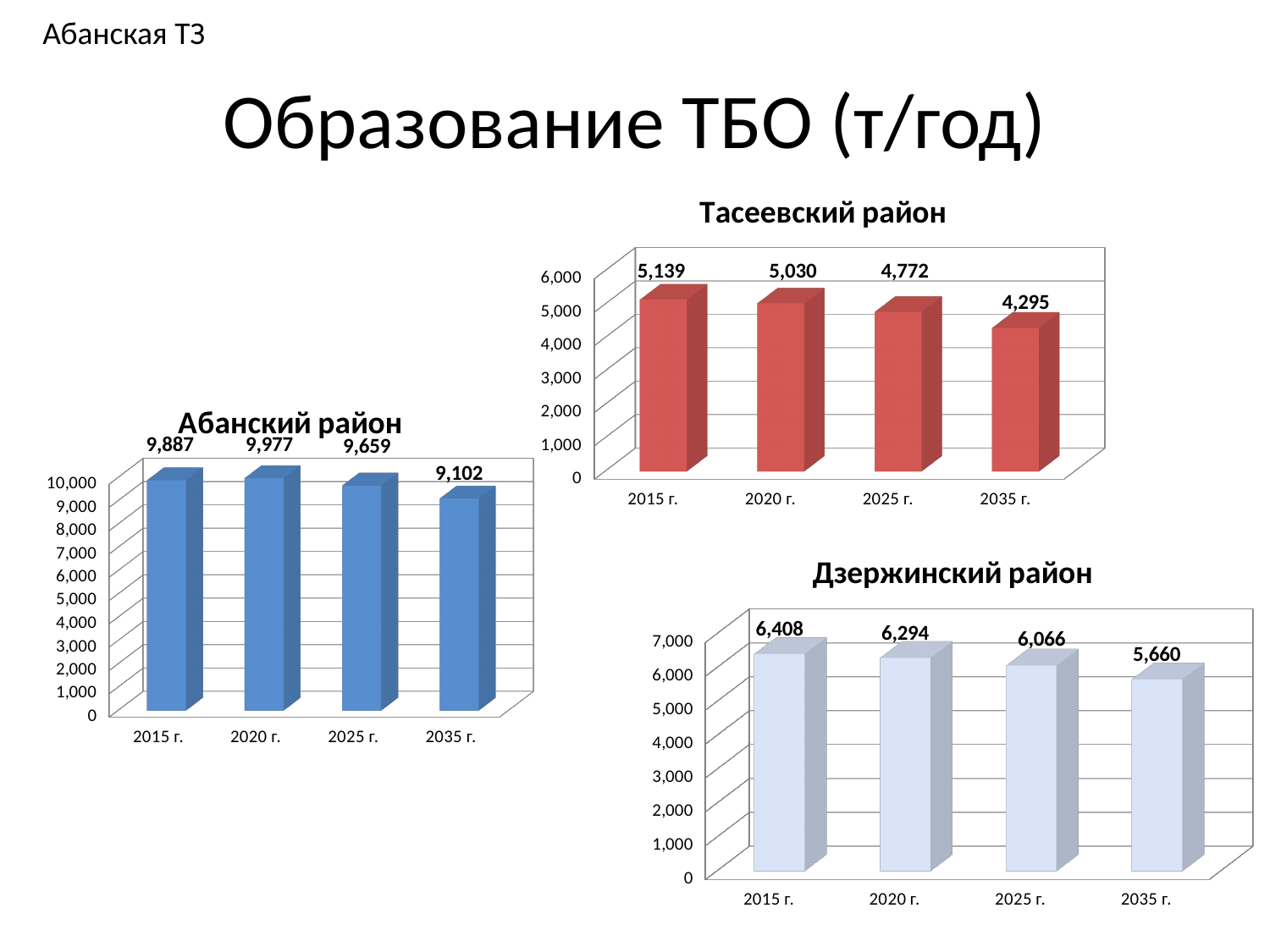
In the 'Тасеевский район' chart, do the values rise or fall from 2015 г. to 2035 г.? fall In the 'Тасеевский район' chart, what is the difference between the values for 2015 г. and 2020 г.? 109 What kind of chart is the 'Дзержинский район' chart? bar chart In the 'Тасеевский район' chart, which year has the lowest value? 2035 г. In the 'Дзержинский район' chart, is the value for 2035 г. greater or less than 6,000? less In the 'Тасеевский район' chart, what is the value for 2035 г.? 4,295 In the 'Дзержинский район' chart, what is the difference between the values for 2015 г. and 2035 г.? 748 In the 'Абанский район' chart, what is the value for 2020 г.? 9,977 In the 'Дзержинский район' chart, what is the value for 2025 г.? 6,066 In the 'Абанский район' chart, which year has the highest value? 2020 г. How many years are shown in the 'Тасеевский район' chart? 4 In the 'Абанский район' chart, which is larger: the value for 2015 г. or the value for 2025 г.? 2015 г.